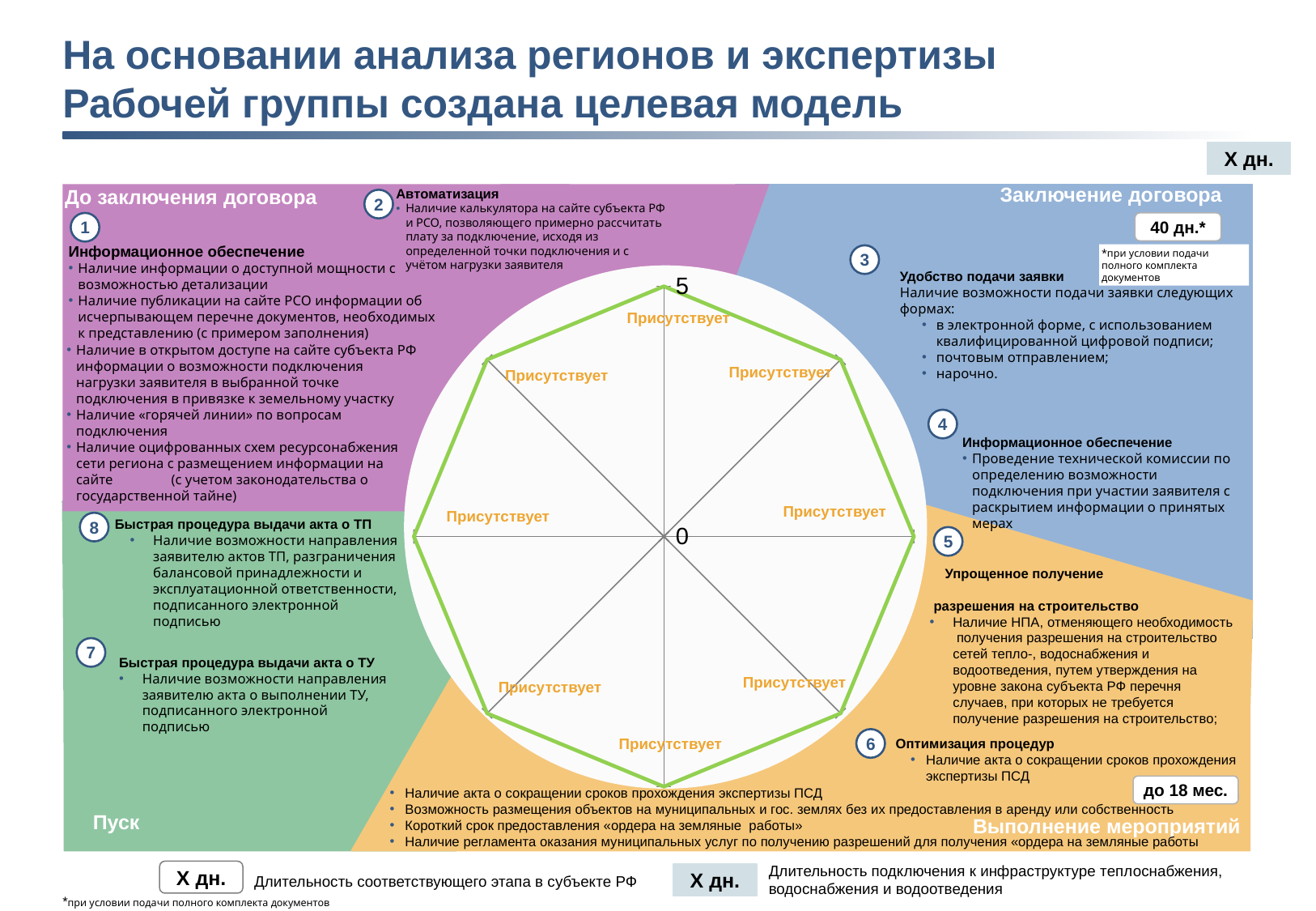
Do the values on the radar chart differ between points, or are they all the same? all the same How many data points (axes) does the radar chart have? 8 What value is printed at the centre of the radar chart? 0 On which axis tick do all the plotted points of the radar chart lie? 5 What data label is shown at every point of the radar chart? Присутствует What colour is the plotted line on the radar chart? green Is the value of the topmost point on the radar chart greater or less than 0? greater What kind of chart is shown in the centre of the slide? radar chart How many data series are plotted on the radar chart? 1 What is the maximum value shown on the radar chart's axis? 5